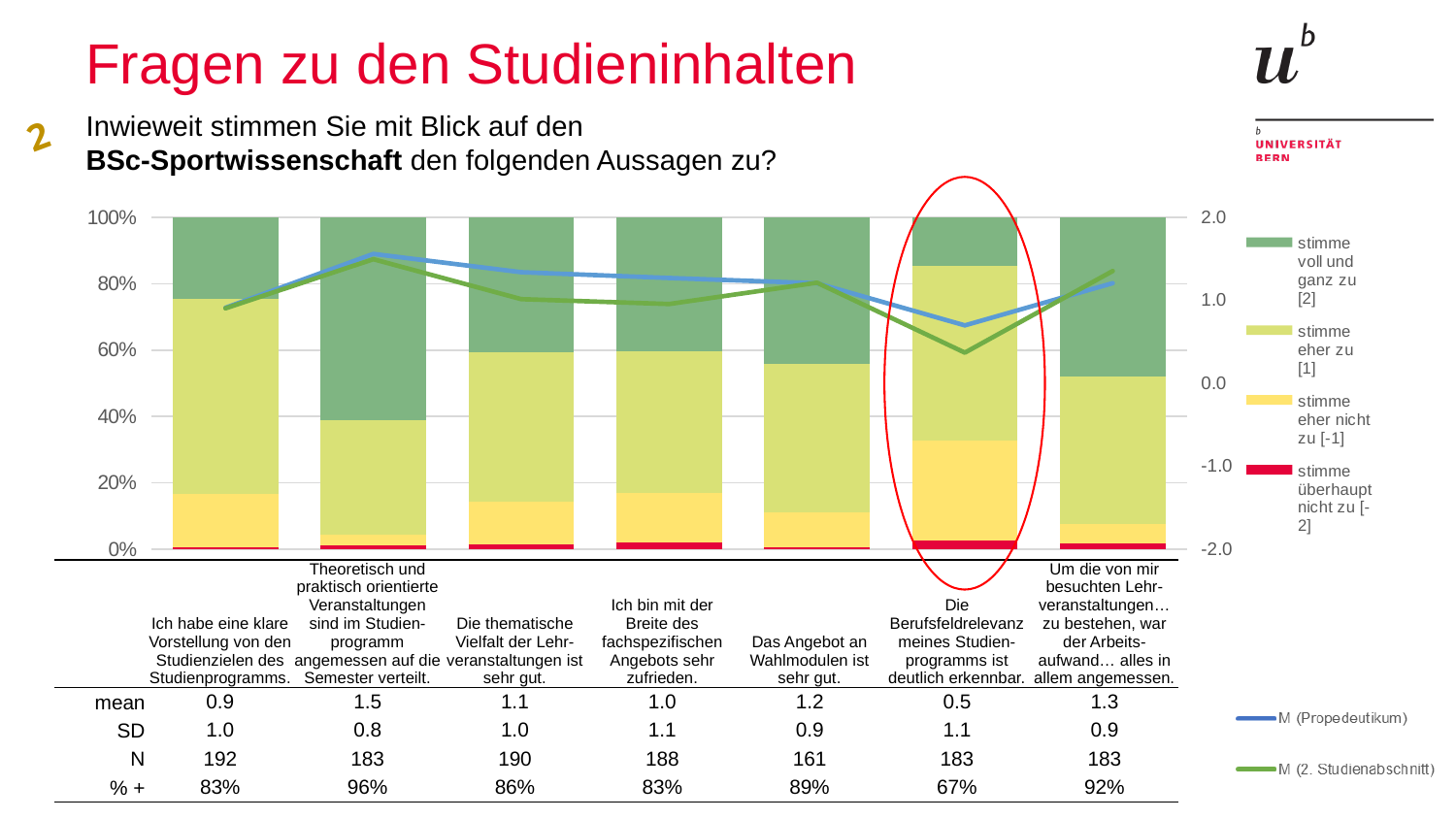
Which statement has the highest mean value? Theoretisch und praktisch orientierte Veranstaltungen sind im Studienprogramm angemessen auf die Semester verteilt How many agreement levels does the legend on the right list for the stacked bars? 4 Which has a larger N: "Ich habe eine klare Vorstellung von den Studienzielen des Studienprogramms" or "Das Angebot an Wahlmodulen ist sehr gut"? Ich habe eine klare Vorstellung von den Studienzielen des Studienprogramms What is the "% +" value for the statement "Theoretisch und praktisch orientierte Veranstaltungen sind im Studienprogramm angemessen auf die Semester verteilt"? 96% What is the SD for the statement "Ich bin mit der Breite des fachspezifischen Angebots sehr zufrieden"? 1.1 What is the N for the statement "Das Angebot an Wahlmodulen ist sehr gut"? 161 Which statement has the lowest "% +" value? Die Berufsfeldrelevanz meines Studienprogramms ist deutlich erkennbar What kind of chart is used to show the agreement levels? stacked bar chart What is the difference between the highest and lowest "% +" values shown in the table? 29 percentage points How many statements (bars) are shown in the chart? 7 Is the "stimme voll und ganz zu" share for the statement "Theoretisch und praktisch orientierte Veranstaltungen sind im Studienprogramm angemessen auf die Semester verteilt" greater or less than 40%? greater What is the mean value for the statement "Die Berufsfeldrelevanz meines Studienprogramms ist deutlich erkennbar"? 0.5